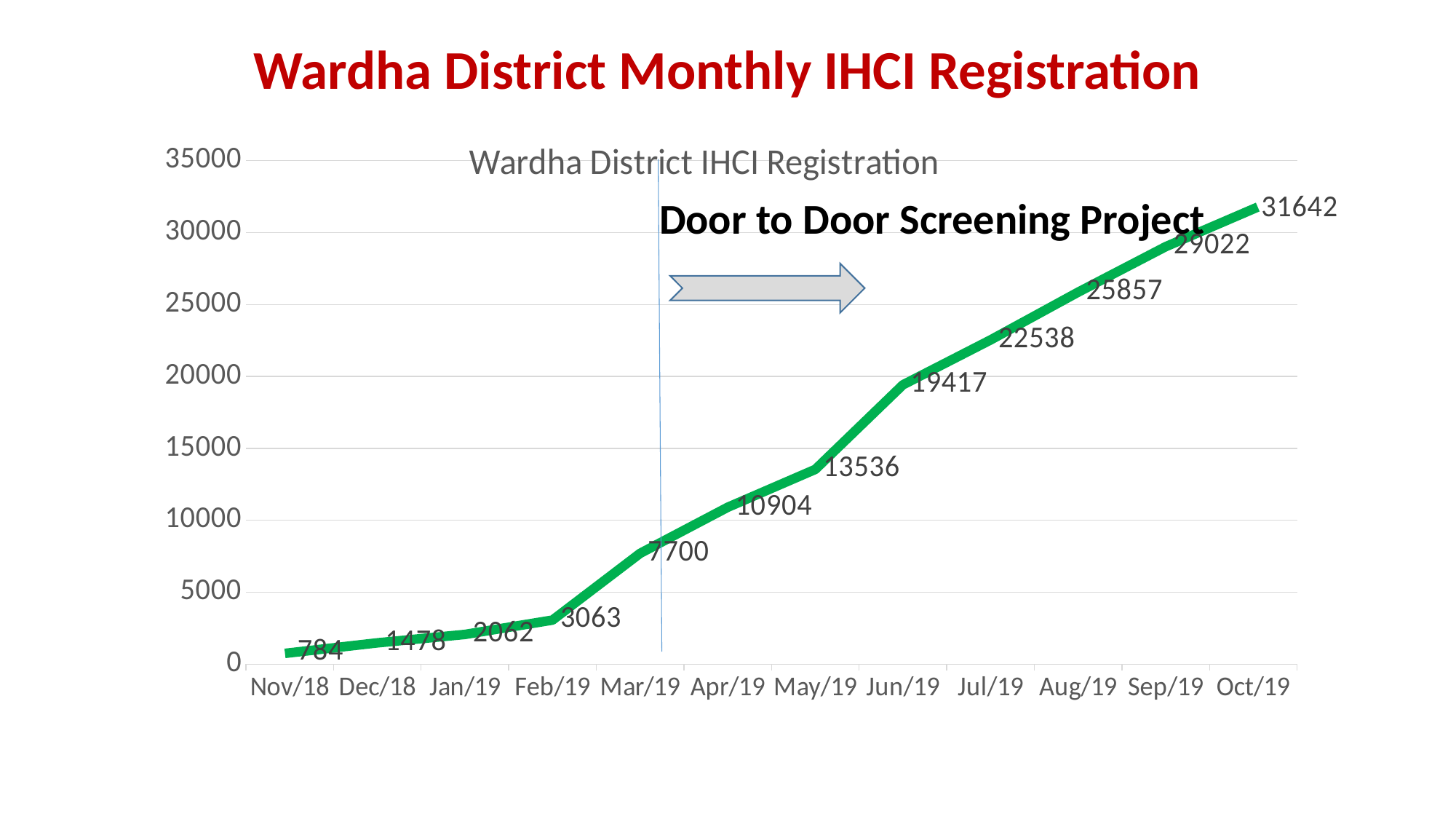
What is the IHCI registration value for Oct/19? 31642 What is the difference between the values for Jun/19 and May/19? 5881 Which month has the highest IHCI registration value? Oct/19 Do the values rise or fall from Nov/18 to Oct/19? Rise Is the value for Aug/19 greater or less than 25000? greater What kind of chart is shown on the slide? Line chart Which month has the lowest IHCI registration value? Nov/18 What is the IHCI registration value for Nov/18? 784 Which is larger, the value for Feb/19 or the value for Apr/19? Apr/19 What is the IHCI registration value for Mar/19? 7700 How many months are plotted on the x axis? 12 What is the IHCI registration value for Jun/19? 19417